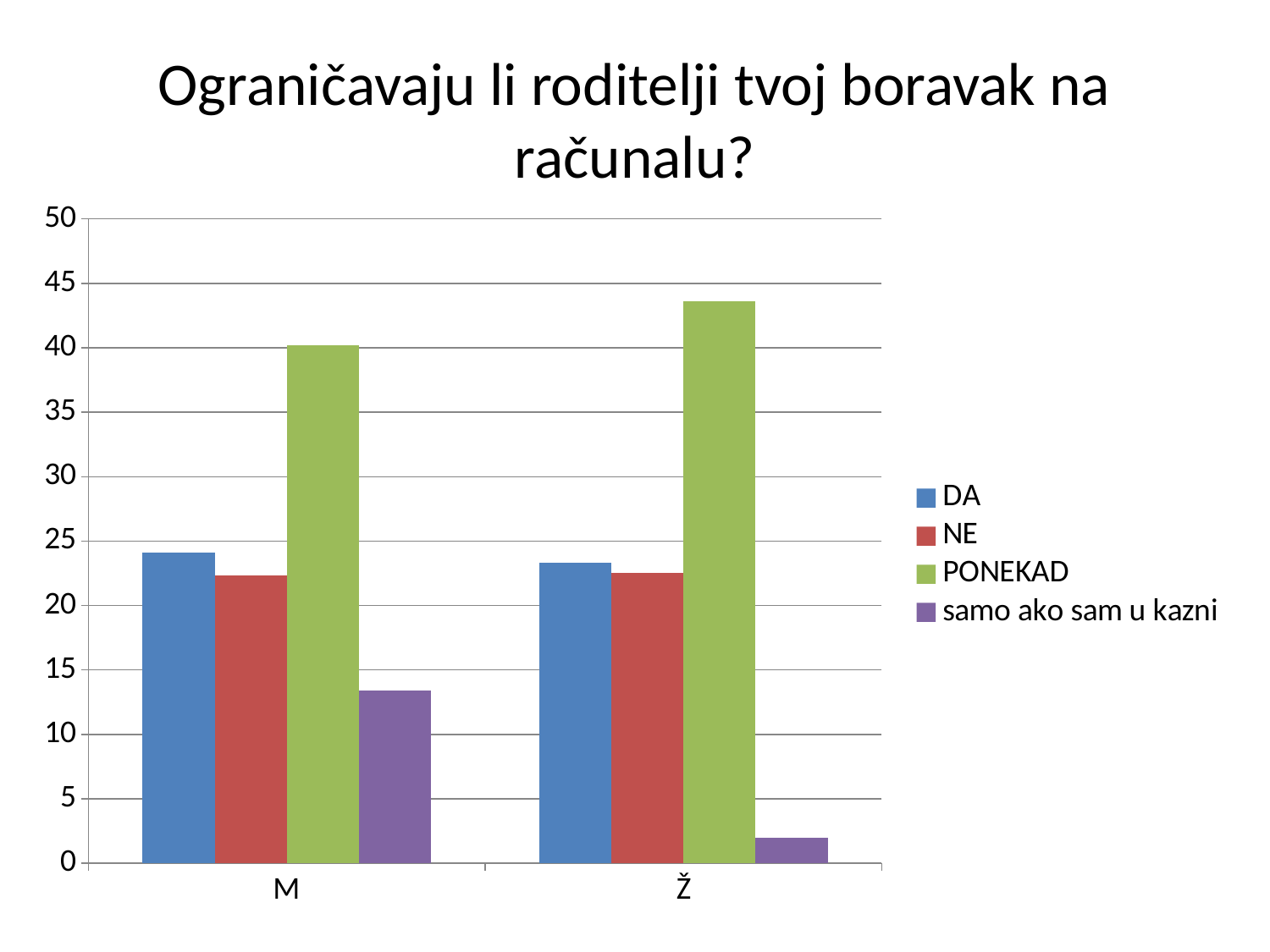
Is the 'samo ako sam u kazni' value for Ž greater or less than 5? less How many categories are shown on the x axis? 2 How many series does the legend list? 4 What is the title of the chart? Ograničavaju li roditelji tvoj boravak na računalu? Is the PONEKAD value for Ž greater or less than 40? greater Which series has the highest value for category M? PONEKAD What kind of chart is shown on the slide? bar chart Is the PONEKAD value for M greater or less than 35? greater Which series has the lowest value for category Ž? samo ako sam u kazni Which is larger, the 'samo ako sam u kazni' value for M or for Ž? M Which is larger, the PONEKAD value for M or for Ž? Ž